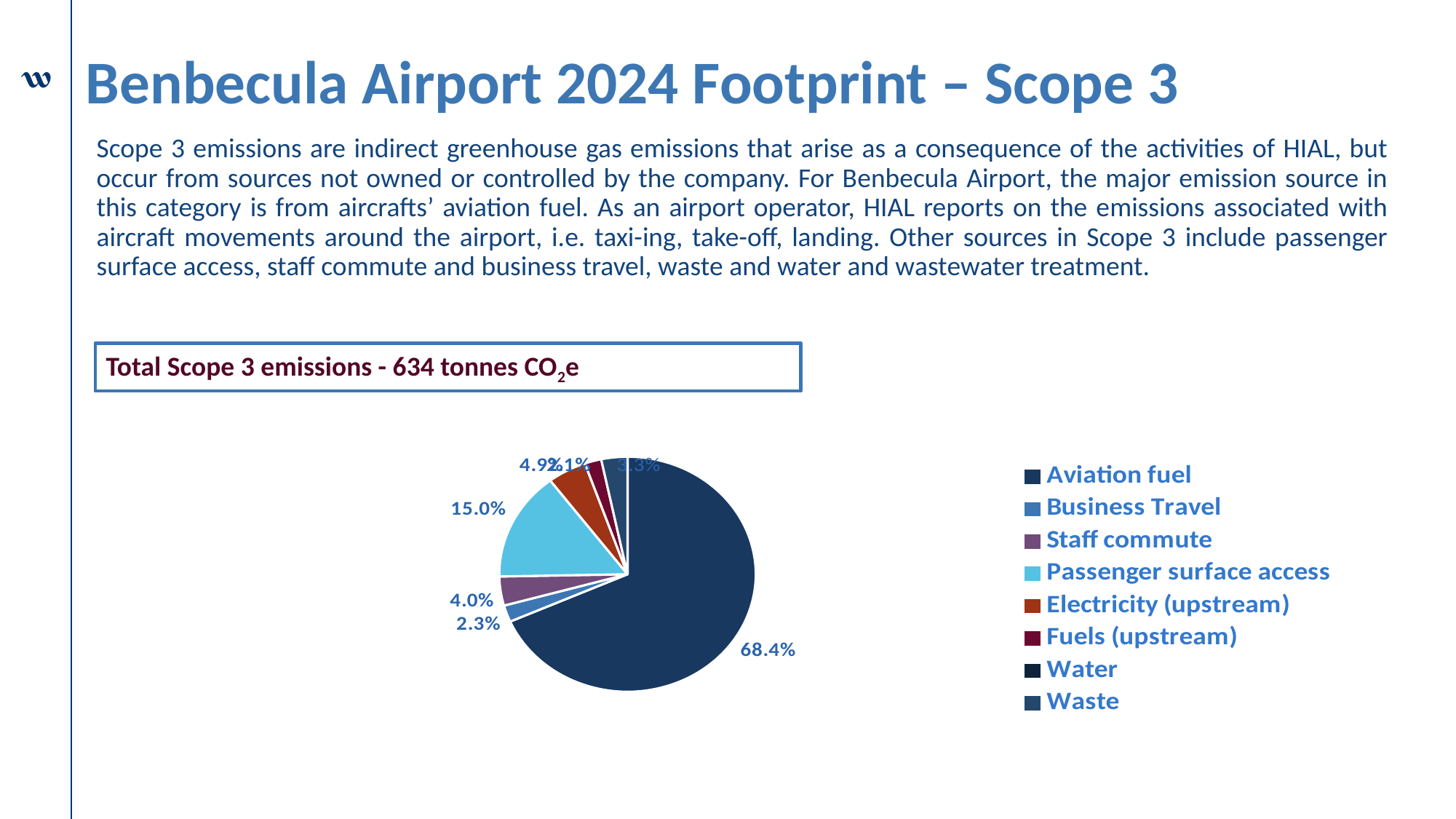
Which is larger, the share for Passenger surface access or the share for Staff commute? Passenger surface access What percentage is shown for Staff commute? 4.0% What percentage is shown for Passenger surface access? 15.0% What percentage is shown for Business Travel? 2.3% By how many percentage points does Aviation fuel exceed Passenger surface access? 53.4 percentage points What total Scope 3 emissions figure is stated above the chart? 634 tonnes CO2e How many categories does the legend list? 8 What percentage is shown for Electricity (upstream)? 4.9% What share of the pie does Aviation fuel account for? 68.4% Which category has the largest slice of the pie? Aviation fuel What kind of chart is shown on the slide? Pie chart Which is larger, the share for Staff commute or the share for Business Travel? Staff commute